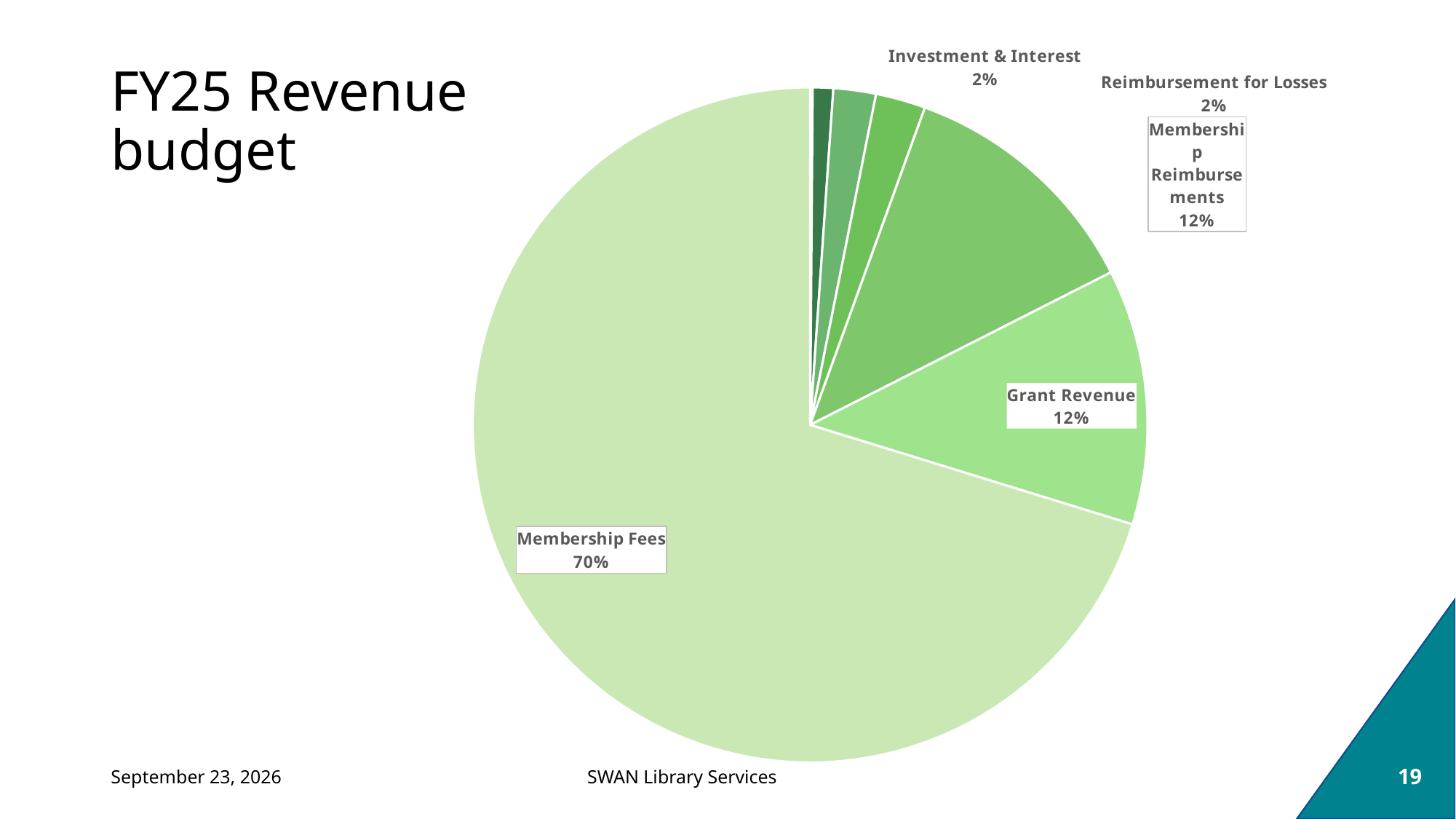
What is the value shown for Grant Revenue? 12% What kind of chart is shown on the slide? pie chart What is the value shown for Membership Reimbursements? 12% What is the value shown for Investment & Interest? 2% Which is larger, Grant Revenue or Reimbursement for Losses? Grant Revenue What share of the pie does Membership Fees account for? 70% What is the combined share of Grant Revenue and Membership Reimbursements? 24% Which is larger, Membership Fees or Membership Reimbursements? Membership Fees Which category has the largest slice of the pie? Membership Fees What is the title of the slide containing the chart? FY25 Revenue budget What is the value shown for Reimbursement for Losses? 2% What is the difference between the Membership Fees share and the Grant Revenue share? 58%